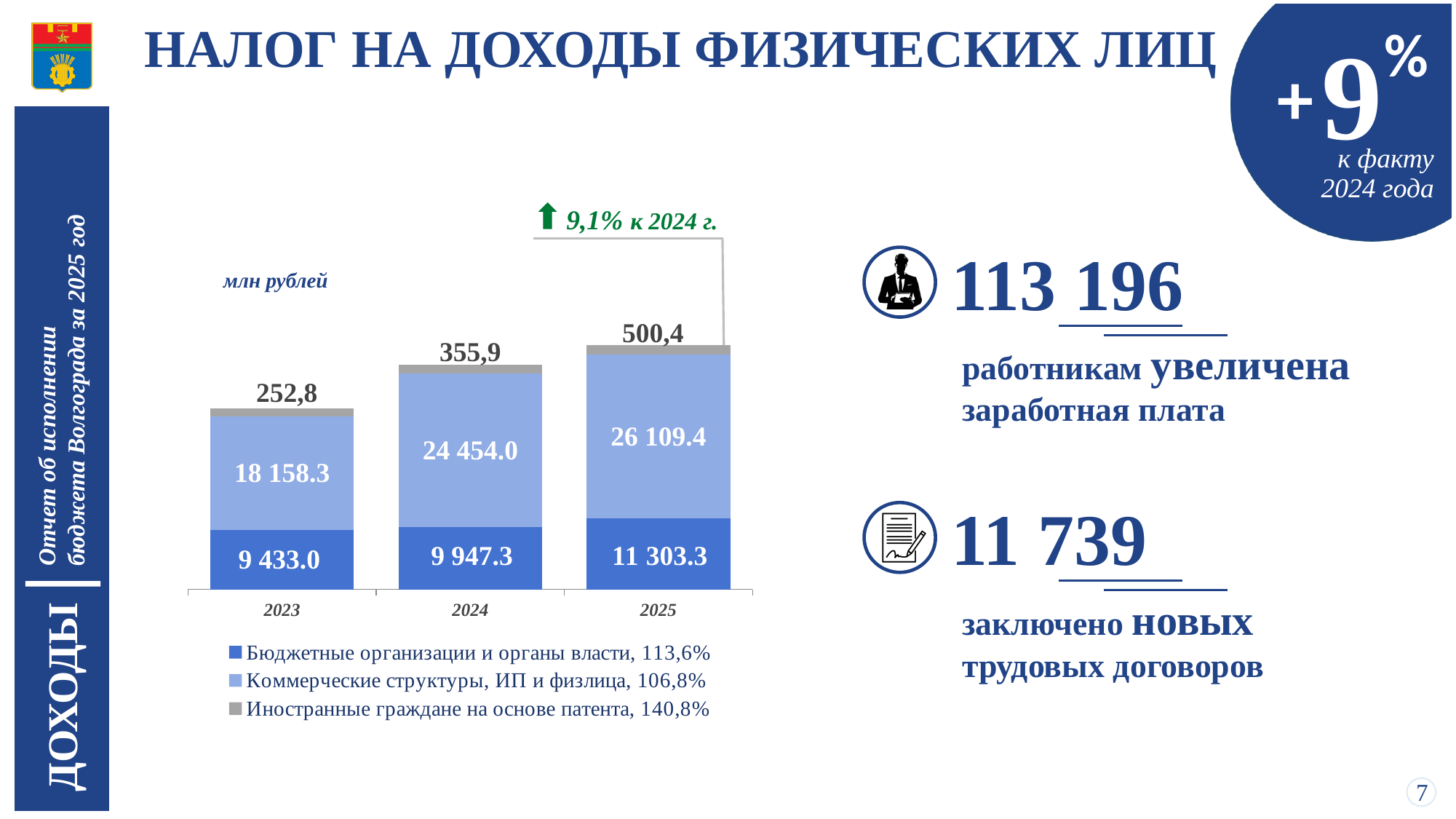
What is the difference between the Бюджетные организации и органы власти values for 2024 and 2023? 514.3 How many years are shown on the x axis of the chart? 3 How many series does the chart legend list? 3 Which year has the lowest value for Бюджетные организации и органы власти? 2023 What total value is printed above the 2023 bar? 252,8 Which year has the larger value for Коммерческие структуры, ИП и физлица, 2024 or 2025? 2025 Do the totals printed above the bars rise or fall from 2023 to 2025? rise Which year has the highest total printed above its bar? 2025 What is the value for Бюджетные организации и органы власти in 2025? 11 303.3 What is the value for Коммерческие структуры, ИП и физлица in 2024? 24 454.0 What kind of chart is shown on the slide? bar chart What is the difference between the totals printed above the 2025 and 2024 bars? 144,5